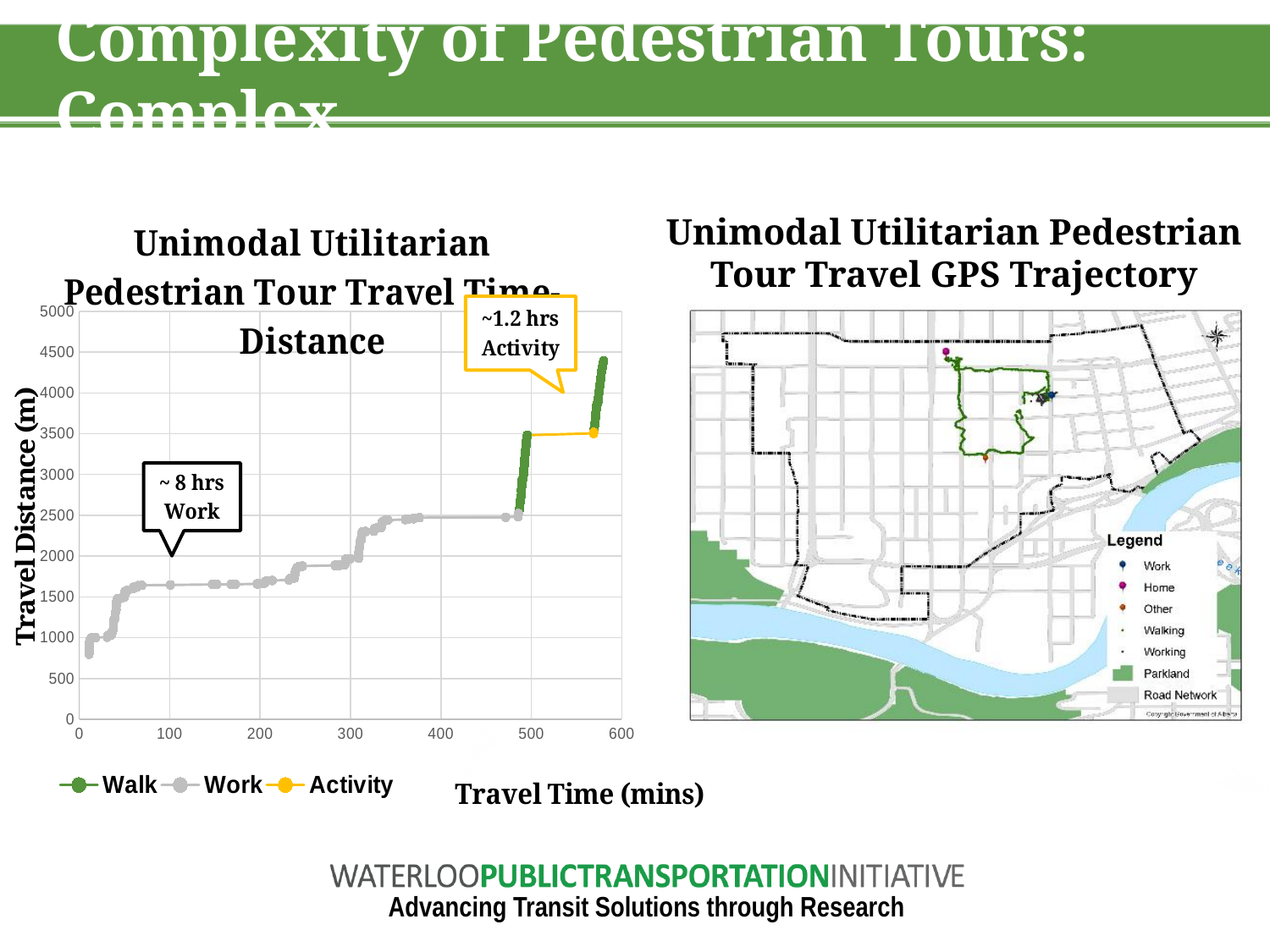
What is the y-axis title of the Travel Time-Distance chart? Travel Distance (m) In the Travel Time-Distance chart, which is larger: the travel distance at 500 mins or at 300 mins? 500 mins In the Travel Time-Distance chart, is the travel distance at a travel time of 20 mins greater or less than 1500? less How many series does the legend of the Travel Time-Distance chart list? 3 In the Travel Time-Distance chart, is the travel distance at a travel time of 100 mins greater or less than 1500? greater What kind of chart is the Unimodal Utilitarian Pedestrian Tour Travel Time-Distance chart? line chart In the Travel Time-Distance chart, which series is drawn in green? Walk In the Travel Time-Distance chart, is the travel distance during the Activity segment greater or less than 3000? greater In the Travel Time-Distance chart, does the travel distance rise or fall as travel time increases? rise